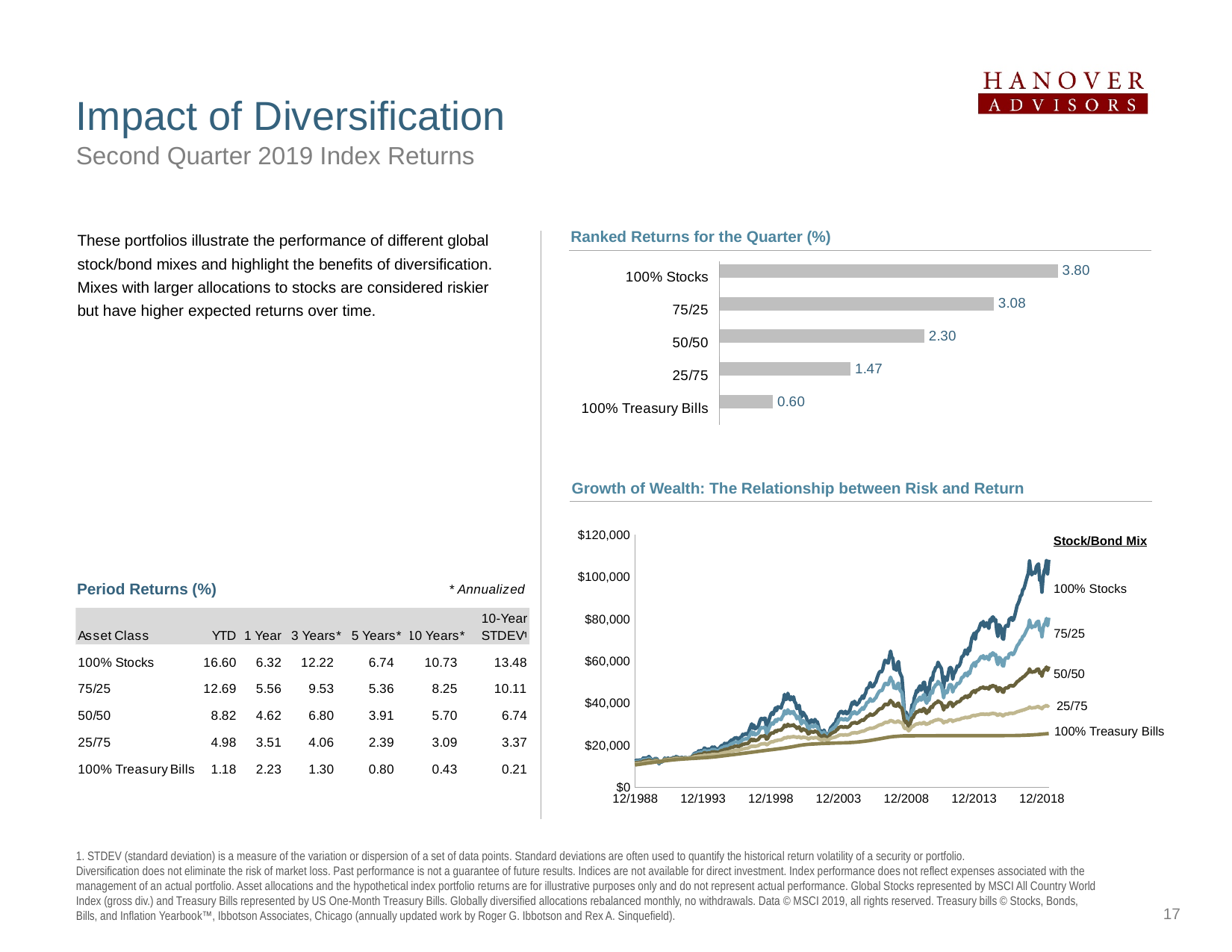
How many portfolios are shown in the Ranked Returns for the Quarter chart? 5 In the Growth of Wealth chart, is the ending value of the 100% Treasury Bills line greater or less than $40,000? less What kind of chart is the Ranked Returns for the Quarter chart? Bar chart In the Ranked Returns for the Quarter chart, what is the value for 50/50? 2.30 In the Ranked Returns for the Quarter chart, what is the difference between the values for 75/25 and 25/75? 1.61 In the Growth of Wealth chart, is the ending value of the 100% Stocks line greater or less than $80,000? greater In the Ranked Returns for the Quarter chart, what is the value for 100% Stocks? 3.80 In the Ranked Returns for the Quarter chart, which portfolio has the highest return? 100% Stocks In the Ranked Returns for the Quarter chart, which portfolio has the lowest return? 100% Treasury Bills In the Ranked Returns for the Quarter chart, what is the value for 100% Treasury Bills? 0.60 In the Ranked Returns for the Quarter chart, which is larger, the value for 50/50 or the value for 25/75? 50/50 How many stock/bond mixes are plotted as lines in the Growth of Wealth chart? 5